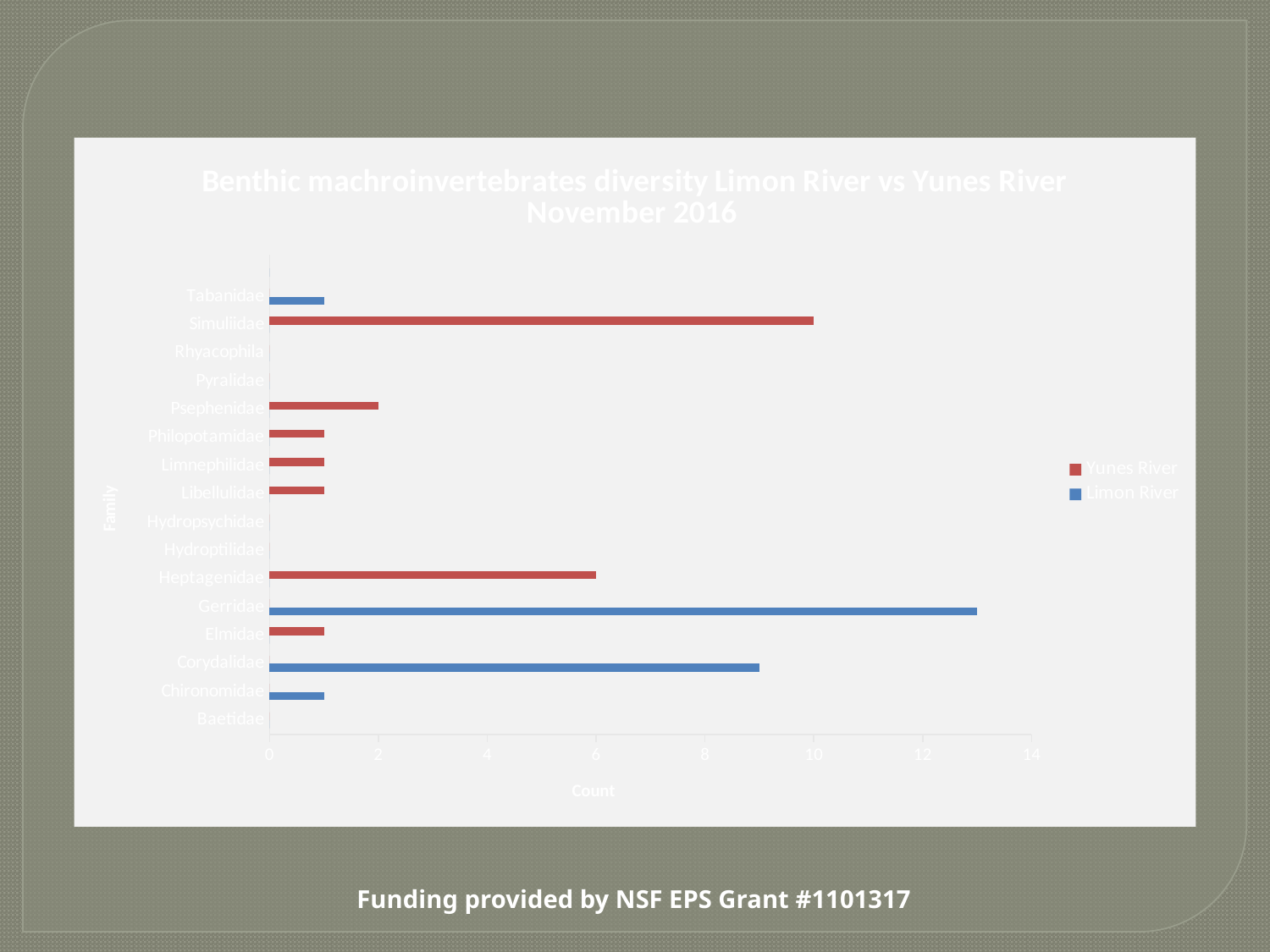
How many series does the legend list? 2 Which is larger for the Yunes River: the count for Simuliidae or the count for Heptagenidae? Simuliidae What is the count for Heptagenidae in the Yunes River? 6 Is the Limon River count for Corydalidae greater or less than 8? greater How many families are listed on the y axis? 16 What kind of chart is shown on the slide? bar chart What is the difference between the Yunes River counts for Simuliidae and Heptagenidae? 4 Which colour represents the Limon River series in the legend? blue What is the count for Psephenidae in the Yunes River? 2 Is the Limon River count for Gerridae greater or less than 12? greater Which family has the longest bar in the chart? Gerridae What is the count for Simuliidae in the Yunes River? 10